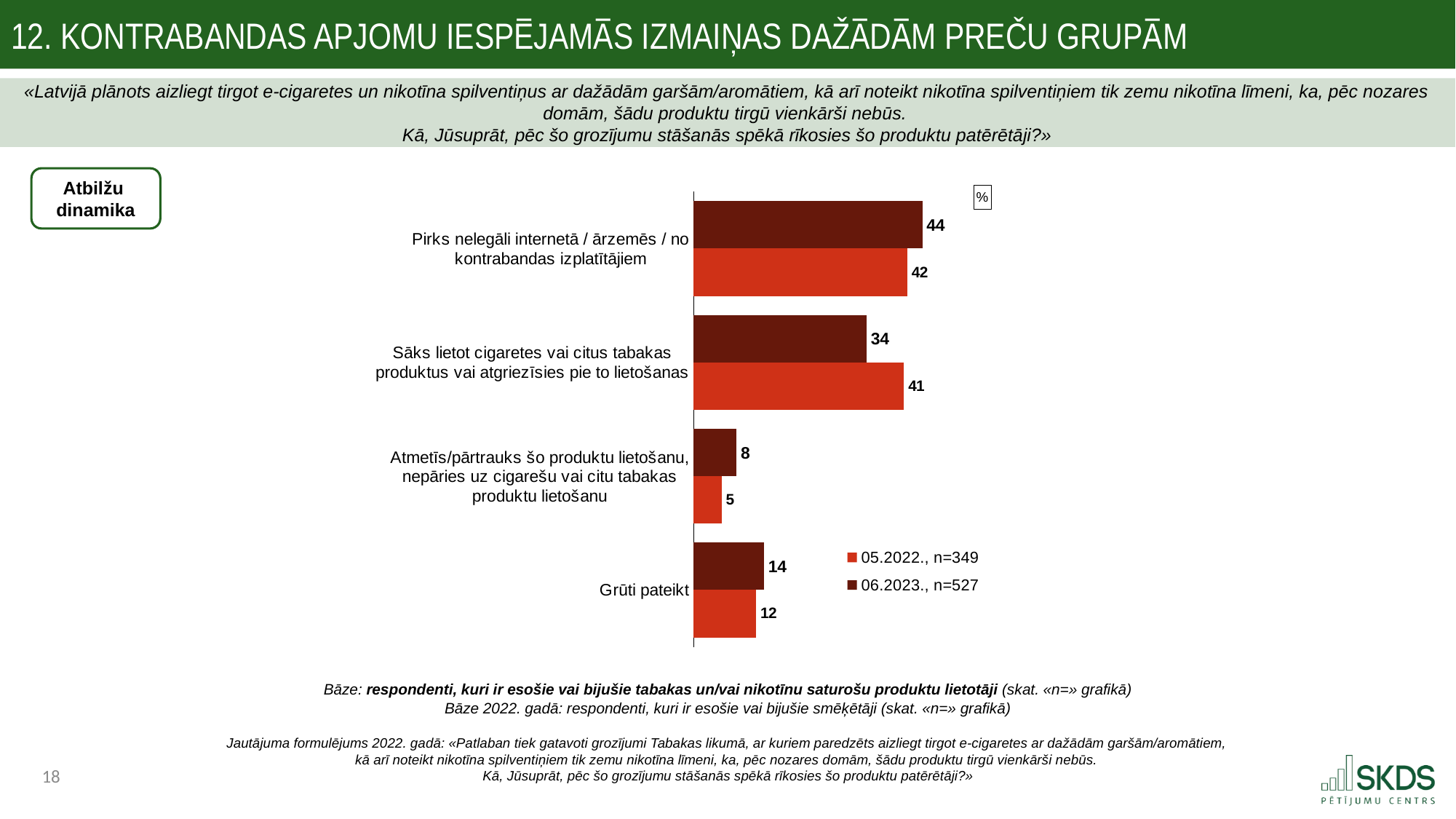
What kind of chart is shown on the slide? Bar chart What is the value for "Sāks lietot cigaretes vai citus tabakas produktus vai atgriezīsies pie to lietošanas" in the 05.2022., n=349 series? 41 What colour are the bars for the 06.2023., n=527 series? Dark red Which category has the highest value in the 06.2023., n=527 series? Pirks nelegāli internetā / ārzemēs / no kontrabandas izplatītājiem For "Grūti pateikt", which series has the larger value: 05.2022., n=349 or 06.2023., n=527? 06.2023., n=527 What is the value for "Pirks nelegāli internetā / ārzemēs / no kontrabandas izplatītājiem" in the 06.2023., n=527 series? 44 What is the value for "Grūti pateikt" in the 05.2022., n=349 series? 12 How many categories are shown on the chart? 4 How many series does the legend list? 2 What is the value for "Atmetīs/pārtrauks šo produktu lietošanu, nepāries uz cigarešu vai citu tabakas produktu lietošanu" in the 06.2023., n=527 series? 8 What is the difference between the 05.2022., n=349 and 06.2023., n=527 values for "Sāks lietot cigaretes vai citus tabakas produktus vai atgriezīsies pie to lietošanas"? 7 Which category has the lowest value in the 05.2022., n=349 series? Atmetīs/pārtrauks šo produktu lietošanu, nepāries uz cigarešu vai citu tabakas produktu lietošanu